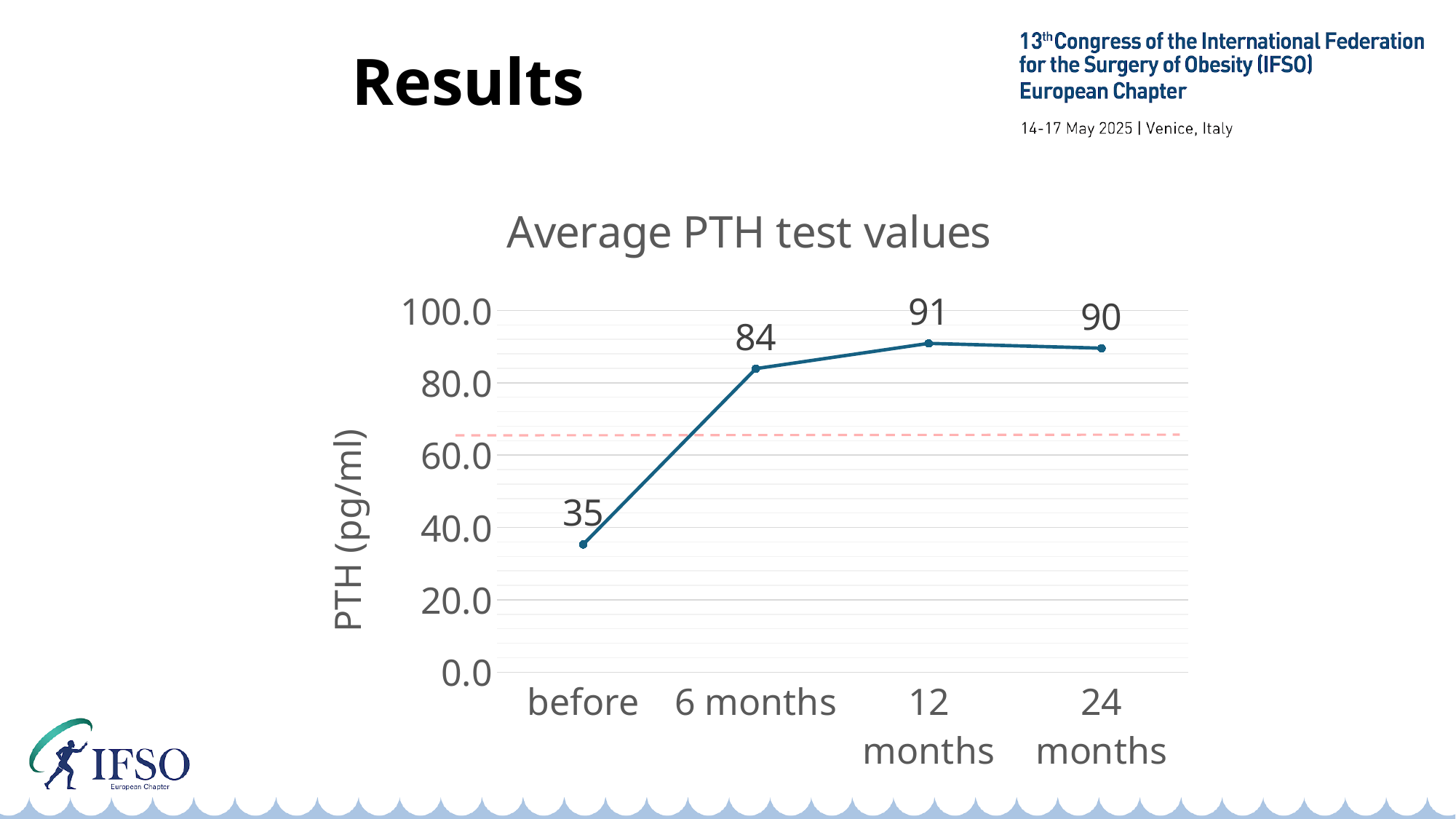
Which is larger, the average PTH value at 6 months or at 24 months? 24 months What is the difference between the average PTH value at 12 months and at 24 months? 1 What is the average PTH value at 12 months? 91 What is the title of the chart? Average PTH test values What is the average PTH value before surgery? 35 How many time points are plotted on the chart? 4 At which time point is the average PTH value highest? 12 months What is the average PTH value at 24 months? 90 What is the difference between the average PTH value at 6 months and before surgery? 49 What is the average PTH value at 6 months? 84 What kind of chart is shown on the slide? line chart At which time point is the average PTH value lowest? before